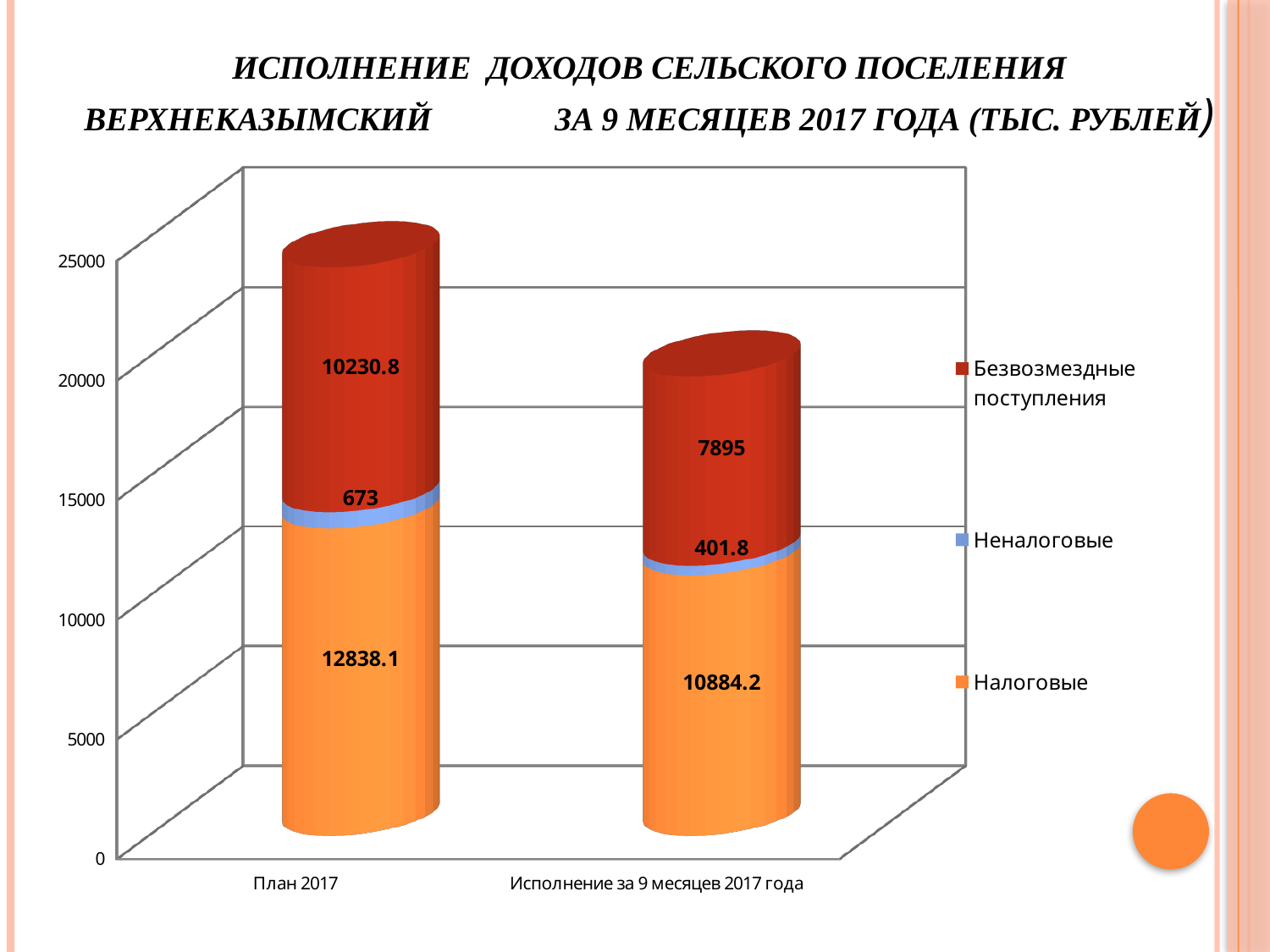
What kind of chart is shown on the slide? Stacked bar chart Which category has the higher value for Налоговые, План 2017 or Исполнение за 9 месяцев 2017 года? План 2017 What is the value of Налоговые for План 2017? 12838.1 How many series does the legend list? 3 What is the value of Неналоговые for План 2017? 673 What is the total of the stacked bar for Исполнение за 9 месяцев 2017 года? 19181 How many categories are shown on the x axis? 2 What is the difference between the Безвозмездные поступления values for План 2017 and Исполнение за 9 месяцев 2017 года? 2335.8 What is the value of Неналоговые for Исполнение за 9 месяцев 2017 года? 401.8 What is the value of Безвозмездные поступления for Исполнение за 9 месяцев 2017 года? 7895 What is the total of the stacked bar for План 2017? 23741.9 What is the difference between the Налоговые values for План 2017 and Исполнение за 9 месяцев 2017 года? 1953.9